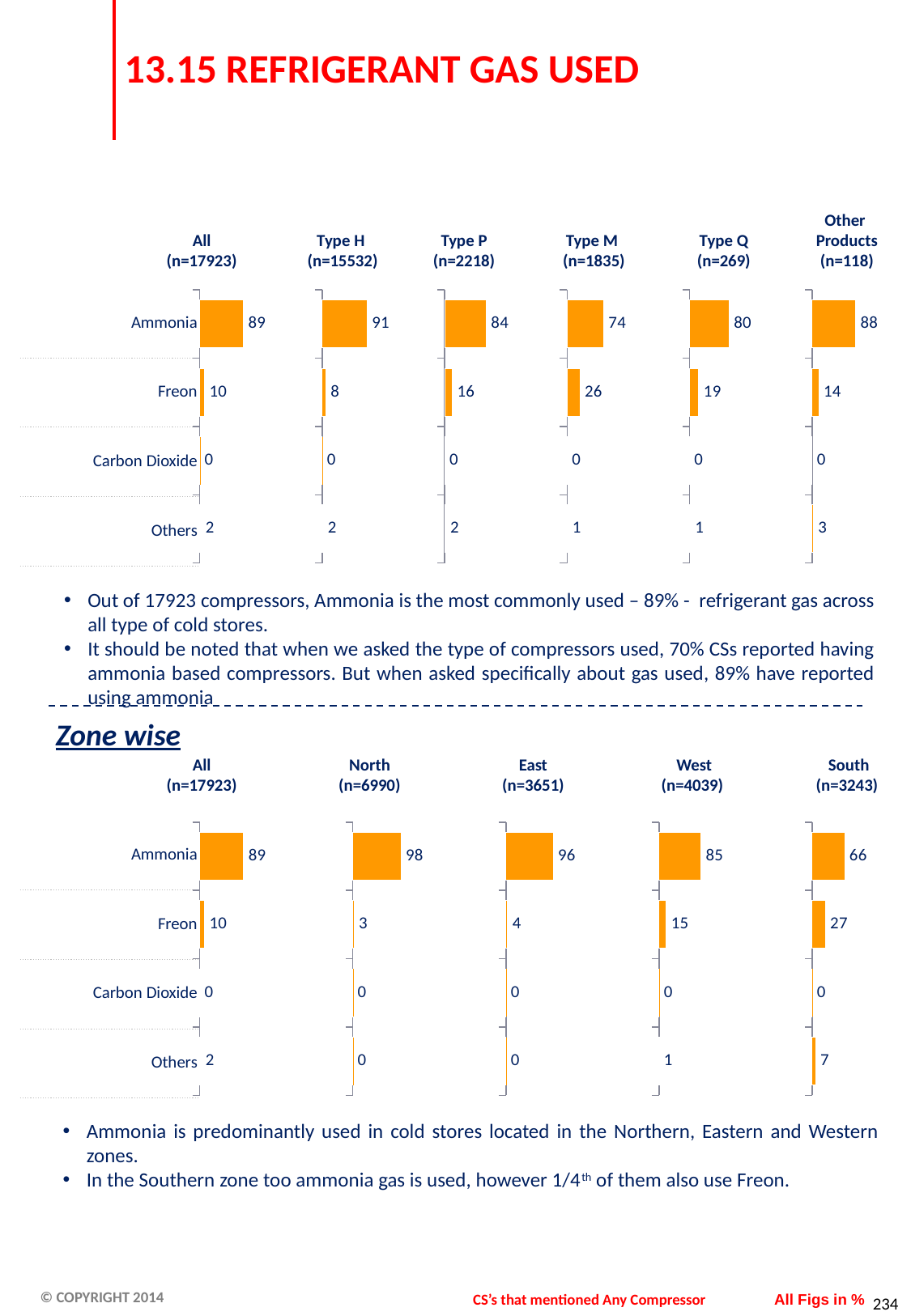
In the Zone wise charts, what is the value for Others in the South (n=3243) chart? 7 In the Zone wise charts, what is the value for Freon in the North (n=6990) chart? 3 In the top set of charts, what is the value for Others in the Other Products (n=118) chart? 3 In the Zone wise charts, what is the value for Ammonia in the South (n=3243) chart? 66 What kind of chart is used to show the refrigerant gas data? Bar chart In the Zone wise charts, which zone has the highest value for Ammonia? North In the top set of charts (by cold store type), what is the value for Ammonia in the Type P (n=2218) chart? 84 In the top set of charts, which type has the lowest value for Ammonia? Type M In the top set of charts, what is the value for Freon in the Type M (n=1835) chart? 26 In the Zone wise charts, what is the difference between the Ammonia values for North and South? 32 How many refrigerant gas categories are shown in each chart? 4 In the top set of charts, is the Freon value larger for Type P or Type Q? Type Q